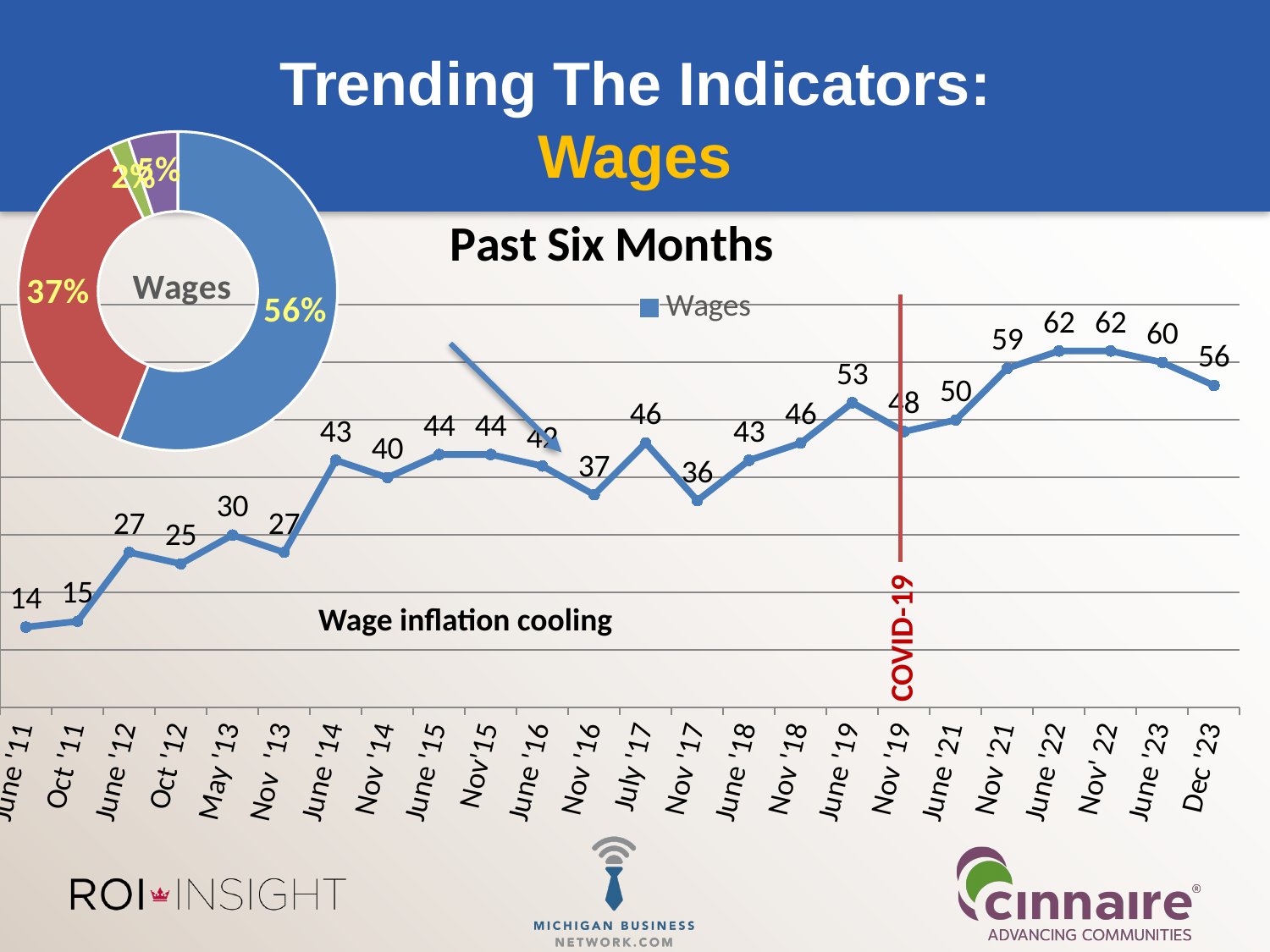
In the donut chart labelled "Wages", what is the share of the largest slice? 56% In the line chart titled "Past Six Months", how many data points are plotted? 24 In the line chart titled "Past Six Months", what is the difference between the values for June '22 and Dec '23? 6 In the line chart titled "Past Six Months", which is larger, the value for June '19 or the value for Nov '17? June '19 In the line chart titled "Past Six Months", what is the value for Nov '19, where the COVID-19 line is drawn? 48 What kind of chart is the "Past Six Months" chart? line chart In the donut chart labelled "Wages", what is the share of the red slice? 37% In the line chart titled "Past Six Months", do the values rise or fall from June '22 to Dec '23? fall In the line chart titled "Past Six Months", what is the highest value plotted? 62 In the line chart titled "Past Six Months", which date has the lowest value? June '11 In the line chart titled "Past Six Months", what is the value for June '11? 14 In the line chart titled "Past Six Months", what is the value for Dec '23? 56